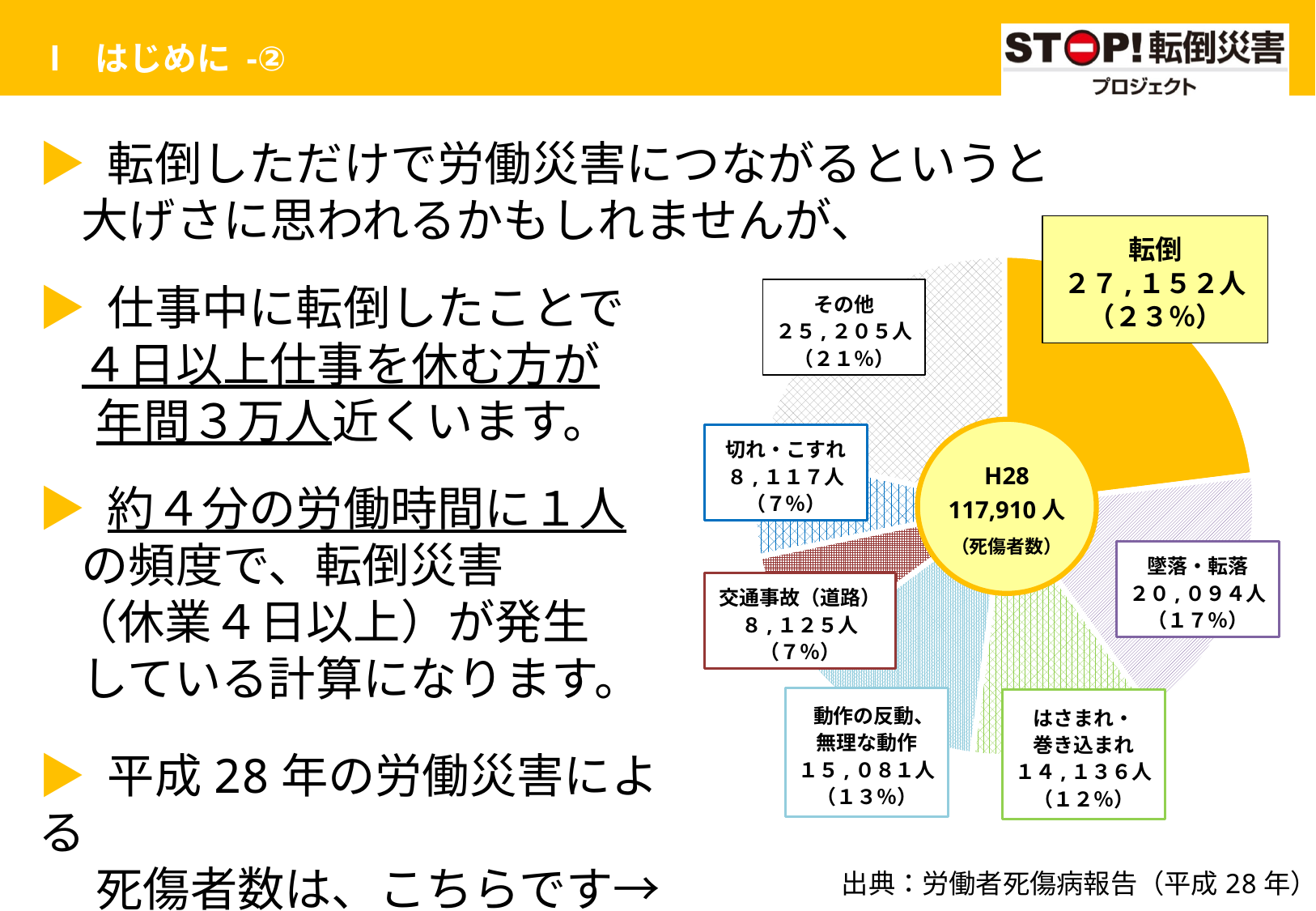
How many categories does the pie chart show? 7 Which category has the largest slice in the pie chart? 転倒 What is the number of people for その他 in the pie chart? 25,205人 What kind of chart is shown on the slide? pie chart What is the number of people for はさまれ・巻き込まれ in the pie chart? 14,136人 What is the number of people for 動作の反動、無理な動作 in the pie chart? 15,081人 What is the number of people for 墜落・転落 in the pie chart? 20,094人 What is the number of people for 転倒 in the pie chart? 27,152人 What is the difference in the number of people between 転倒 and 墜落・転落? 7,058人 What share of the pie does 墜落・転落 represent? 17% What share of the pie does 転倒 represent? 23% What total number of 死傷者数 is shown in the centre of the pie chart? 117,910人